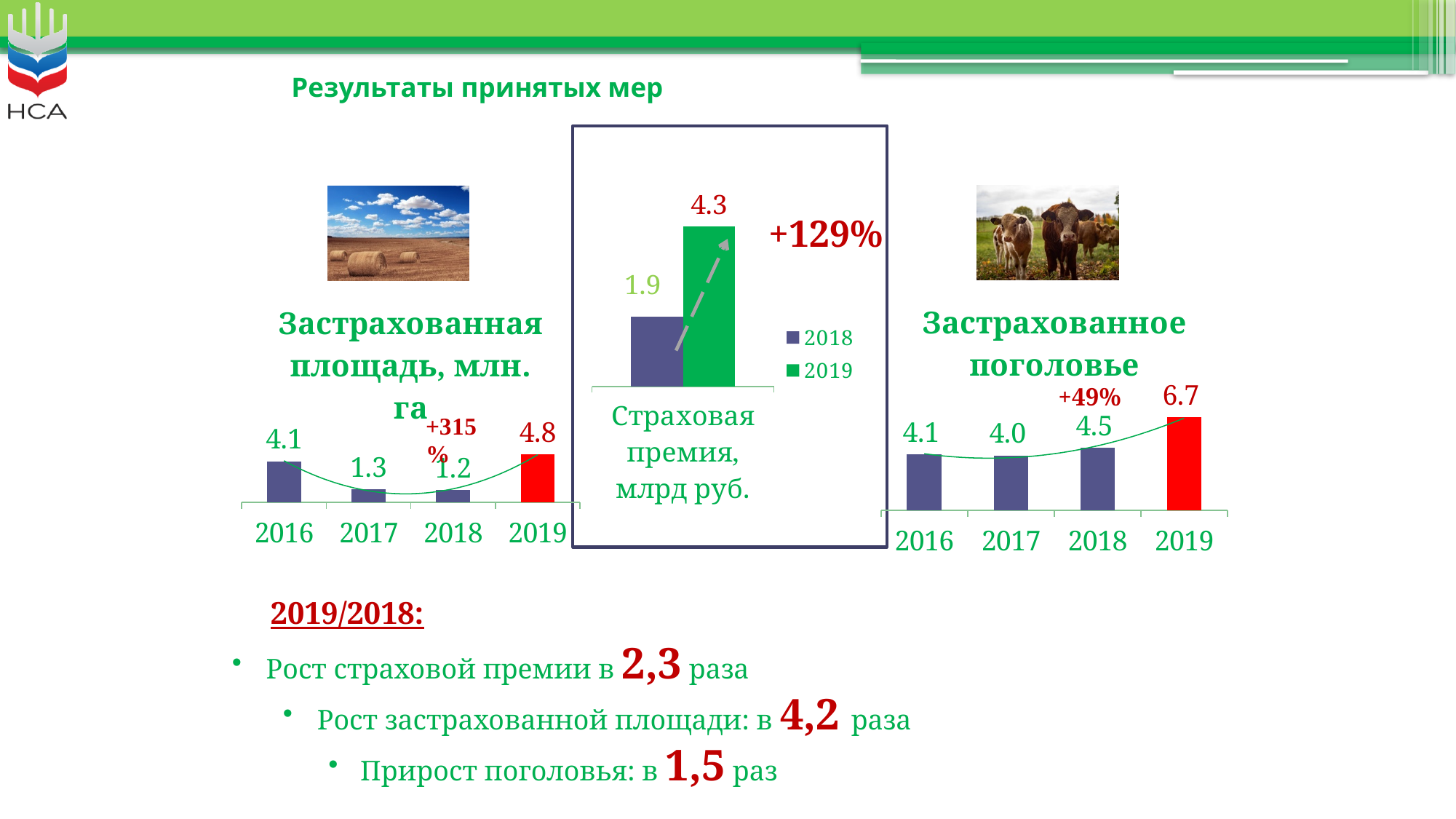
In the 'Застрахованное поголовье' chart, which year has the highest value? 2019 In the 'Застрахованная площадь, млн. га' chart, what is the difference between the 2019 and 2018 values? 3.6 What type of chart is the 'Застрахованное поголовье' chart? Bar chart In the 'Застрахованная площадь, млн. га' chart, which year has the lowest value? 2018 In the 'Страховая премия, млрд руб.' chart, what is the value for 2018? 1.9 In the 'Застрахованная площадь, млн. га' chart, what is the value for 2019? 4.8 In the 'Застрахованное поголовье' chart, what is the difference between the 2019 and 2018 values? 2.2 In the 'Застрахованная площадь, млн. га' chart, how many years are shown on the x axis? 4 In the 'Страховая премия, млрд руб.' chart, what percentage change is annotated next to the bars? +129% In the 'Страховая премия, млрд руб.' chart, what is the value for 2019? 4.3 In the 'Застрахованное поголовье' chart, what is the value for 2017? 4.0 In the 'Страховая премия, млрд руб.' chart, how many series does the legend list? 2